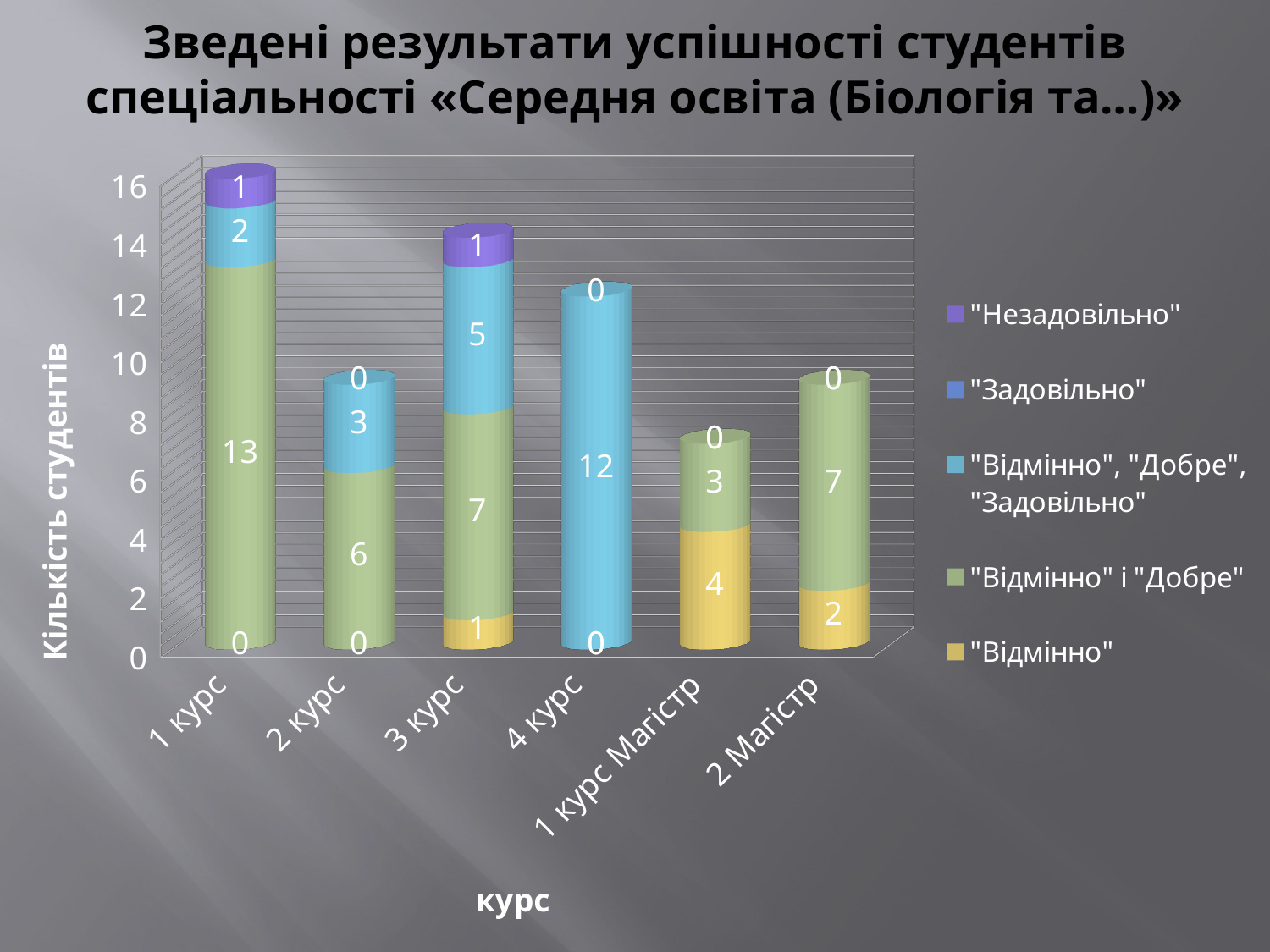
What is the value of "Відмінно", "Добре", "Задовільно" for 4 курс? 12 How many series does the legend list? 5 What is the total of the stacked bar for 1 курс? 16 What kind of chart is shown on the slide? Stacked bar chart What is the value of "Відмінно" for 3 курс? 1 What is the value of "Відмінно" і "Добре" for 2 Магістр? 7 What is the difference between the "Відмінно" і "Добре" values for 3 курс and 2 курс? 1 What is the value of "Відмінно" і "Добре" for 1 курс? 13 Which category has the highest value for "Відмінно" і "Добре"? 1 курс Which has the larger "Відмінно" value, 1 курс Магістр or 2 Магістр? 1 курс Магістр How many categories are shown on the x axis? 6 What is the value of "Відмінно" for 1 курс Магістр? 4